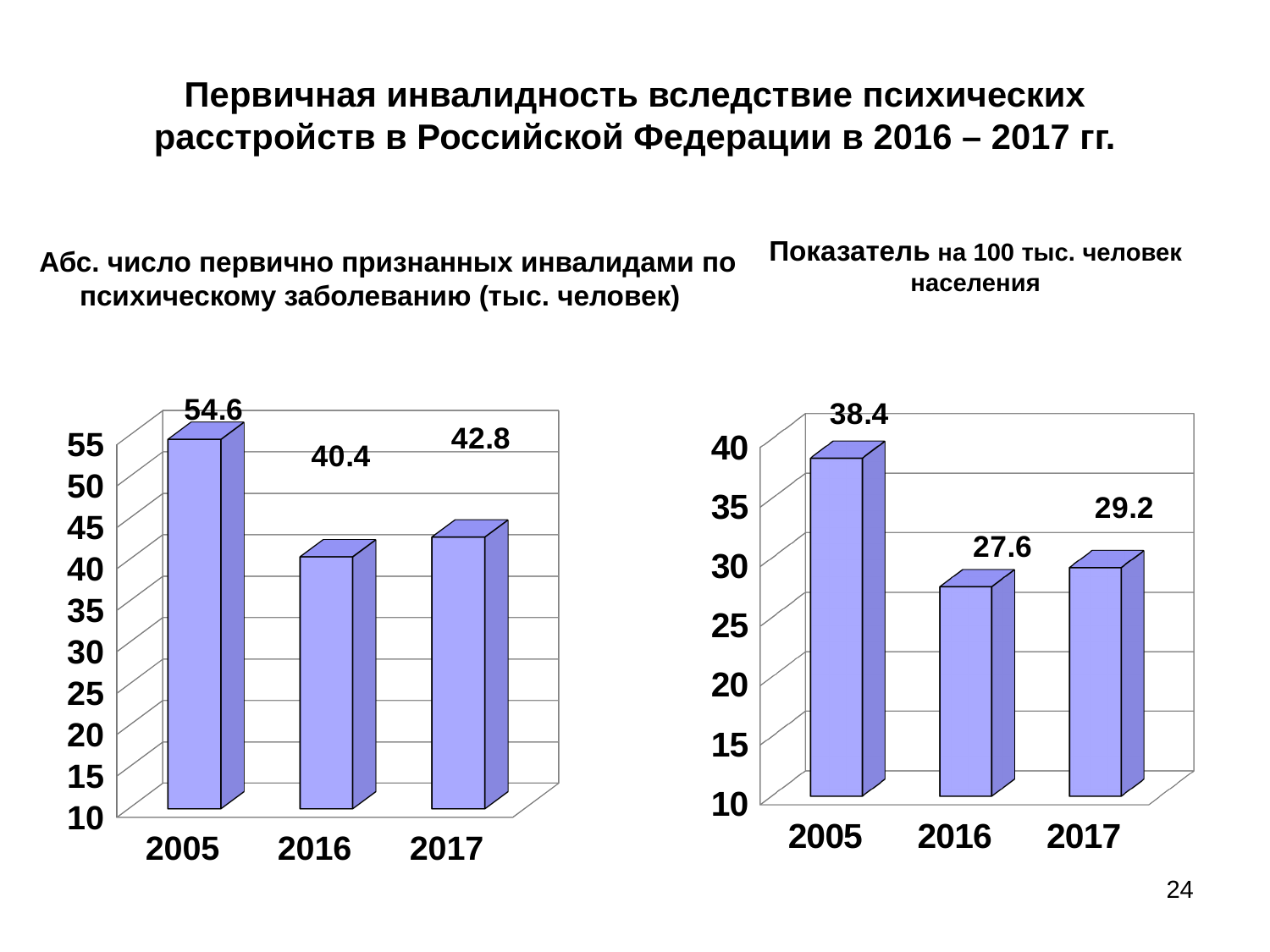
In the left chart (absolute number, thousand people), which year has the highest value? 2005 In the right chart (indicator per 100 thousand population), which is larger: the value for 2016 or the value for 2017? 2017 In the left chart (absolute number, thousand people), is the value for 2017 greater or less than 45? less In the right chart (indicator per 100 thousand population), which year has the lowest value? 2016 What kind of chart is the left chart (absolute number, thousand people)? bar chart In the right chart (indicator per 100 thousand population), what is the value for 2017? 29.2 In the right chart (indicator per 100 thousand population), what is the difference between the 2005 and 2016 values? 10.8 In the left chart (absolute number, thousand people), what is the difference between the 2005 and 2017 values? 11.8 In the right chart (indicator per 100 thousand population), does the value rise or fall from 2016 to 2017? rise How many years are shown on the x axis of the right chart (indicator per 100 thousand population)? 3 In the left chart (absolute number of people first recognised as disabled due to mental illness, thousand people), what is the value for 2005? 54.6 In the left chart (absolute number, thousand people), what is the value for 2016? 40.4